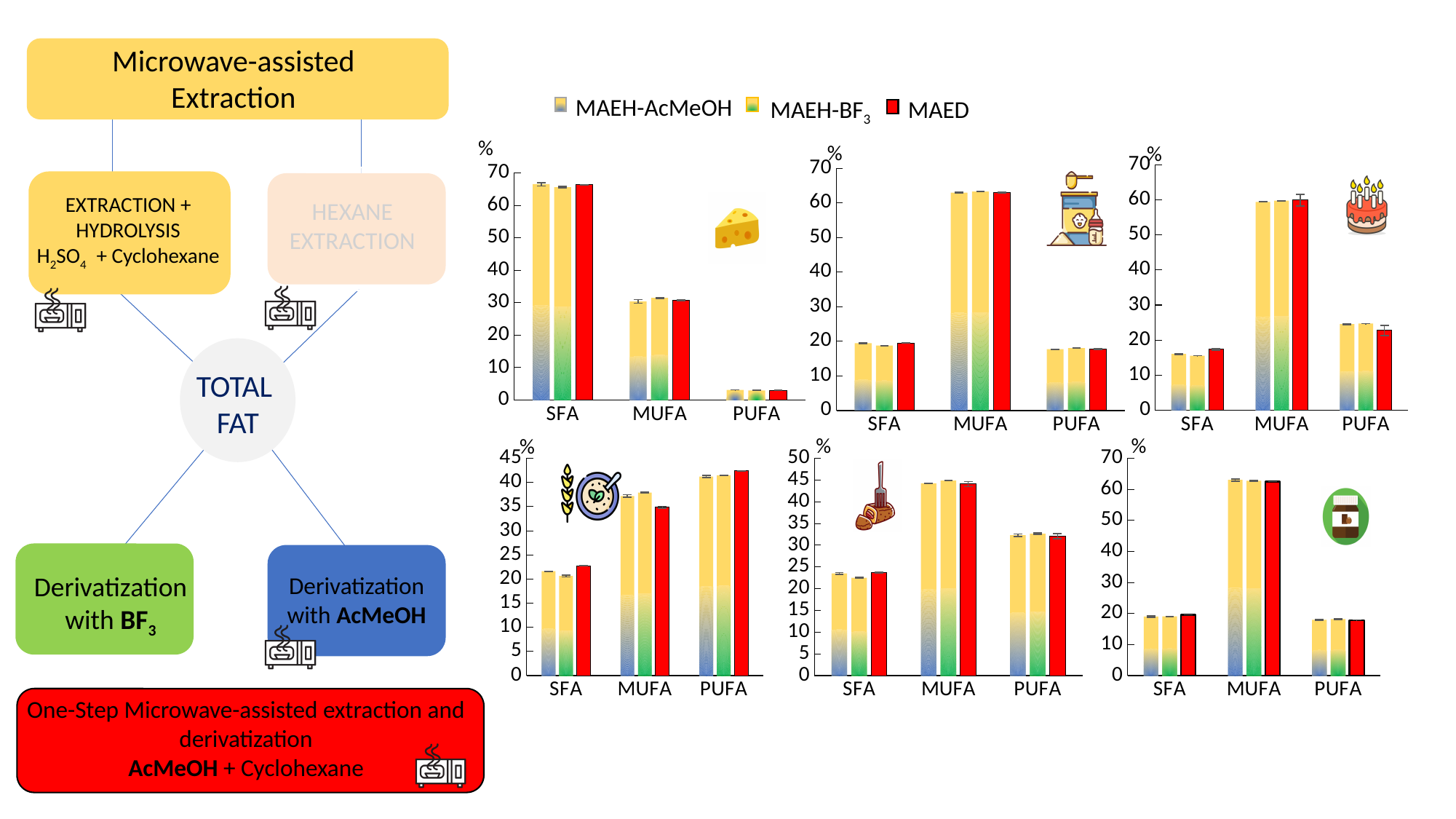
In the top-left chart (cheese icon), which category has the lowest values? PUFA In the top-right chart (cake icon), is the MAED value for MUFA greater or less than 50? greater How many categories are shown on the x axis of the bottom-right chart? 3 In the bottom-middle chart, is the MAED value for MUFA greater or less than 40? greater What kind of chart is the top-left chart (with the cheese icon)? bar chart In the bottom-middle chart, which is larger for MAED: MUFA or PUFA? MUFA In the top-right chart (cake icon), which category has the highest values? MUFA In the top-left chart (cheese icon), which category has the highest values? SFA How many series does the legend above the charts list? 3 In the top-left chart (cheese icon), is the MAED value for SFA greater or less than 60? greater Which series is shown in red in the legend? MAED In the bottom-left chart (cereal bowl icon), which category has the highest values? PUFA